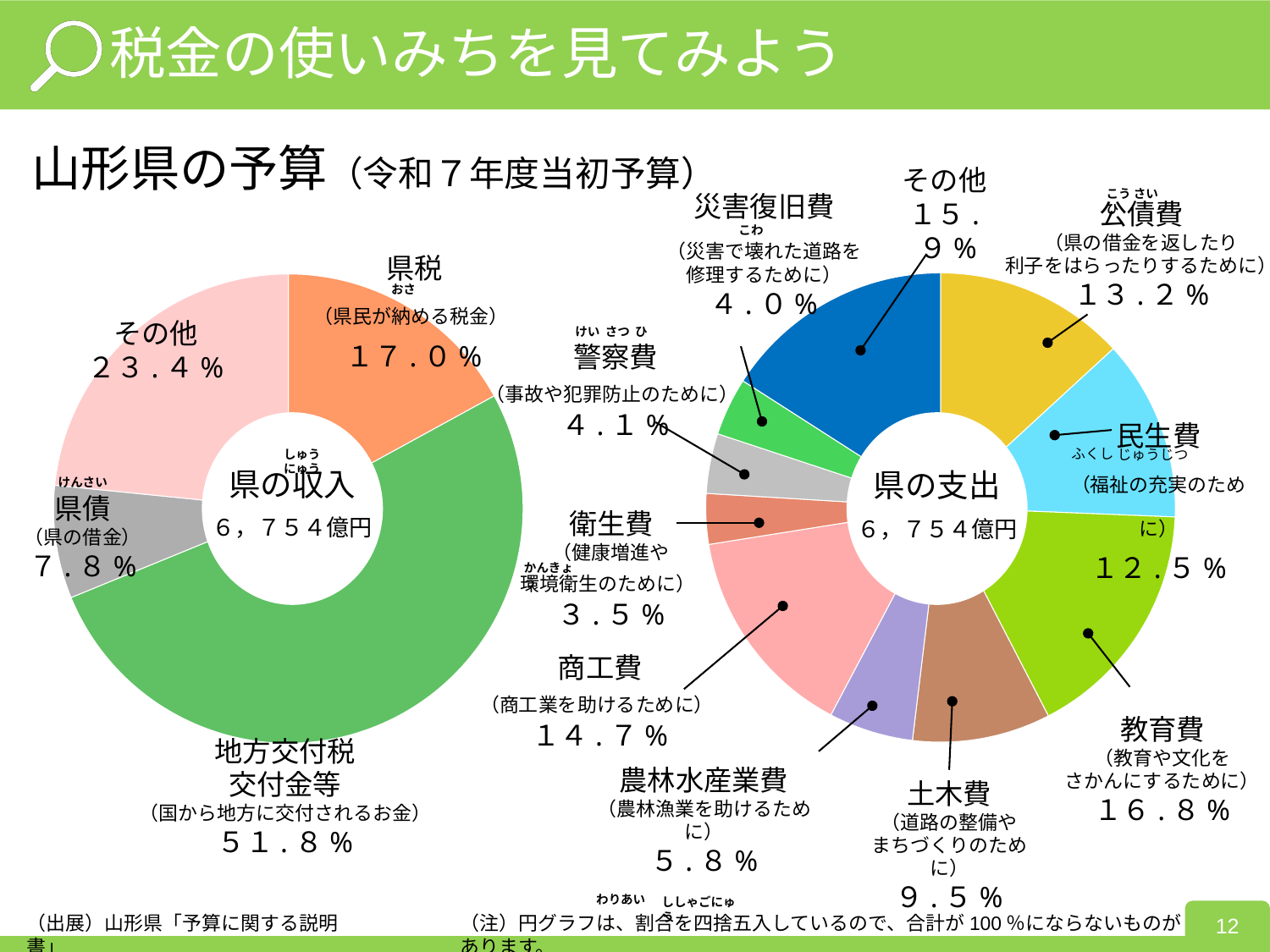
In the 県の支出 chart, which is larger, 公債費 or 民生費? 公債費 In the 県の支出 chart, what share is 教育費? １６．８％ In the 県の収入 chart, what is the difference between その他 and 県債? １５．６％ In the 県の収入 chart, what share is 県税? １７．０％ In the 県の支出 chart, which labelled expense category (excluding その他) has the largest share? 教育費 In the 県の収入 chart, what share is 地方交付税交付金等? ５１．８％ What type of chart is used for 県の収入? Pie (donut) chart In the 県の支出 chart, which category has the smallest share? 衛生費 In the 県の支出 chart, what share is 土木費? ９．５％ How many categories does the 県の支出 chart show? 10 In the 県の支出 chart, what is the difference between 商工費 and 農林水産業費? ８．９％ In the 県の収入 chart, which category has the smallest share? 県債